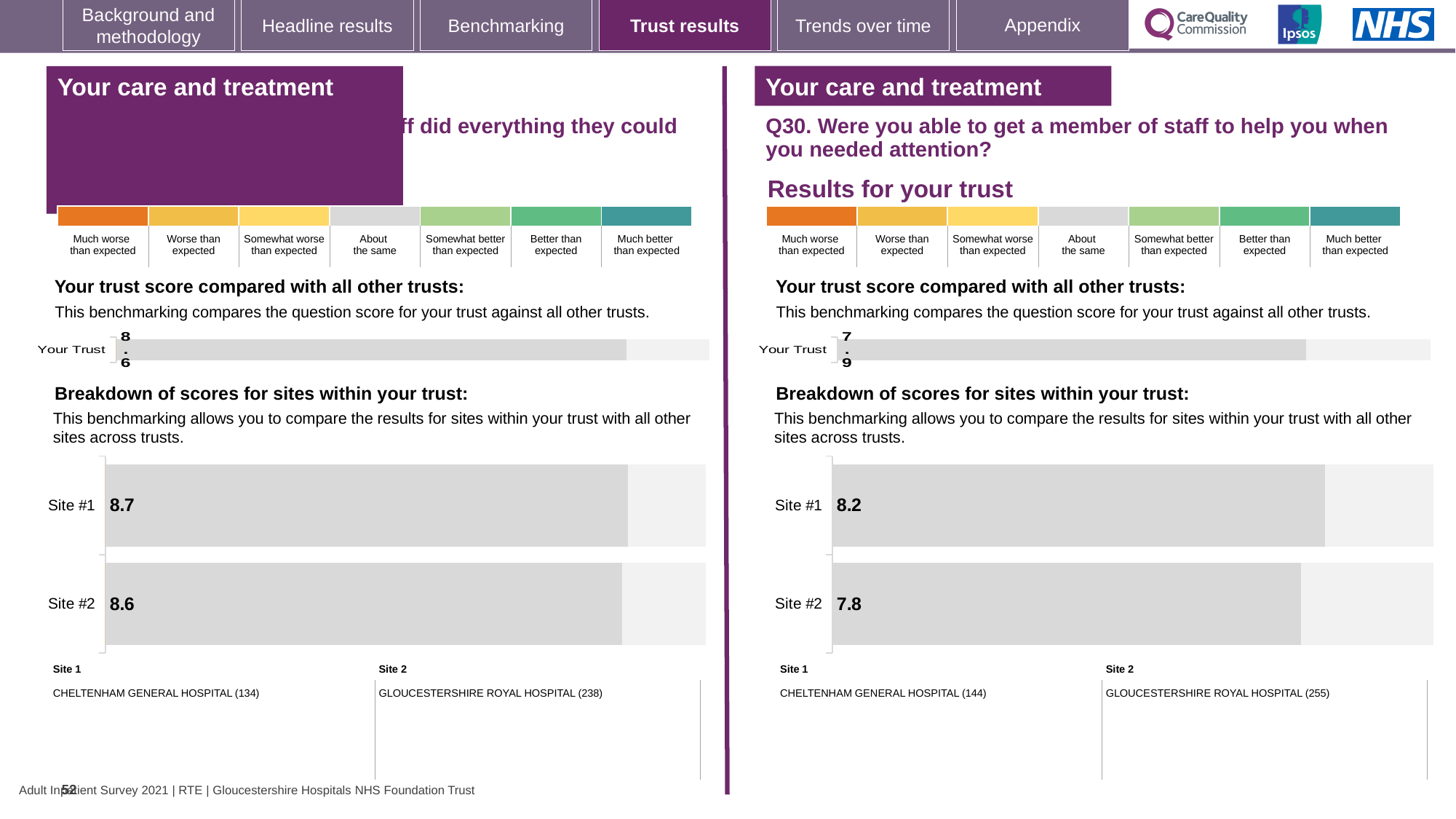
On the left-hand side of the slide, what is the score shown for Your Trust in the 'Your trust score compared with all other trusts' chart? 8.6 In the right-hand (Q30) site breakdown chart, which site has the higher score? Site #1 In the right-hand (Q30) site breakdown chart, which hospital is listed as Site 2? GLOUCESTERSHIRE ROYAL HOSPITAL (255) How many sites are plotted in the right-hand (Q30) site breakdown chart? 2 What type of chart is used for the site breakdown on the left-hand side of the slide? Bar chart In the left-hand 'Breakdown of scores for sites within your trust' chart, what is the score for Site #2? 8.6 In the right-hand (Q30) site breakdown chart, what is the difference between the Site #1 and Site #2 scores? 0.4 In the right-hand (Q30) 'Breakdown of scores for sites within your trust' chart, what is the score for Site #1? 8.2 In the right-hand (Q30) 'Breakdown of scores for sites within your trust' chart, what is the score for Site #2? 7.8 On the right-hand (Q30) side of the slide, what is the score shown for Your Trust in the 'Your trust score compared with all other trusts' chart? 7.9 In the left-hand site breakdown chart, what is the difference between the Site #1 and Site #2 scores? 0.1 In the left-hand 'Breakdown of scores for sites within your trust' chart, what is the score for Site #1? 8.7